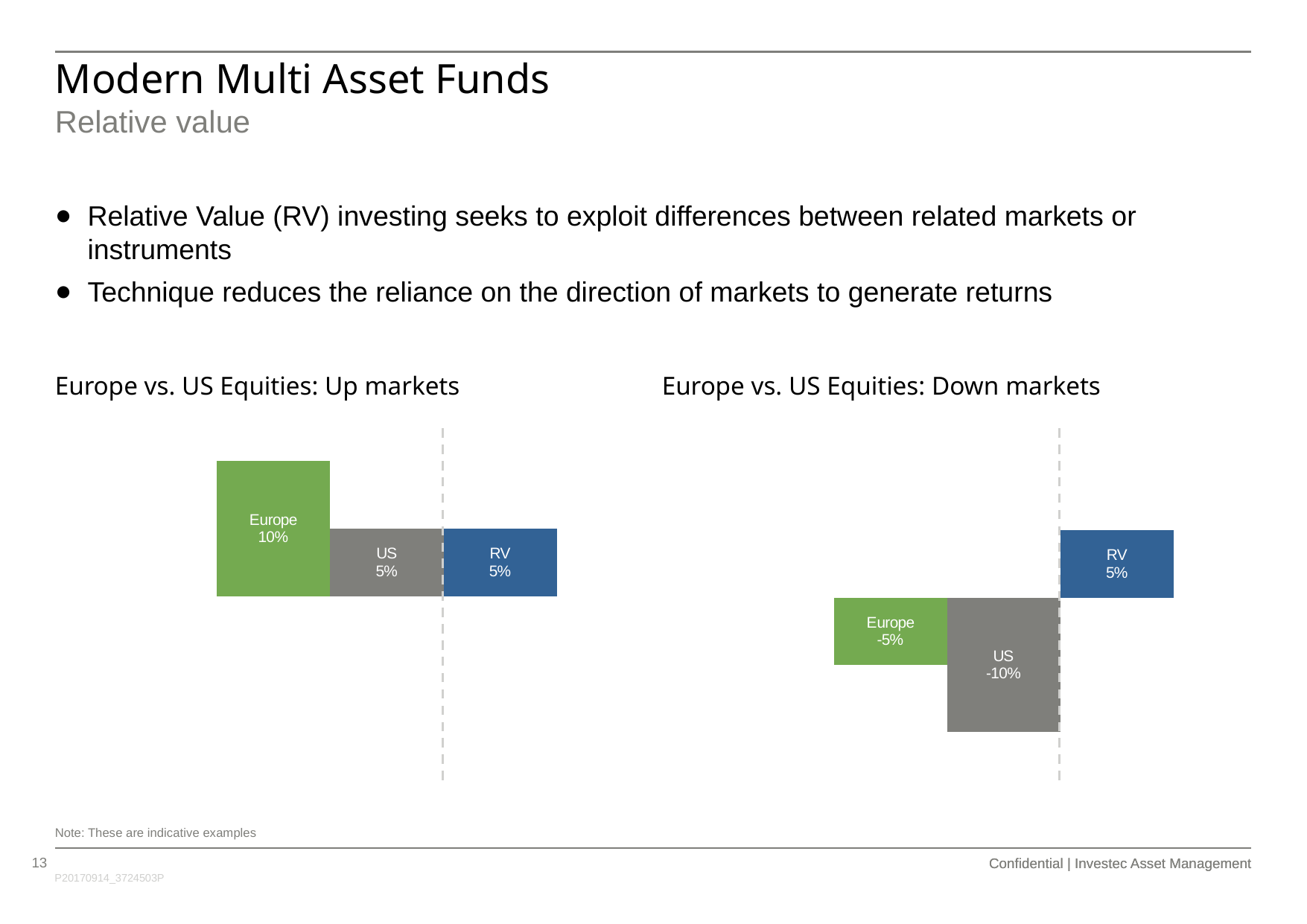
In the 'Europe vs. US Equities: Down markets' chart, which is larger, the Europe value or the US value? Europe In the 'Europe vs. US Equities: Down markets' chart, what is the value for Europe? -5% In the 'Europe vs. US Equities: Up markets' chart, what is the value for US? 5% In the 'Europe vs. US Equities: Up markets' chart, what is the RV value? 5% How many bars are shown in the 'Europe vs. US Equities: Down markets' chart? 3 In the 'Europe vs. US Equities: Up markets' chart, what is the value for Europe? 10% In the 'Europe vs. US Equities: Down markets' chart, which bar has the lowest value? US In the 'Europe vs. US Equities: Down markets' chart, what is the RV value? 5% In the 'Europe vs. US Equities: Up markets' chart, which bar is the highest? Europe In the 'Europe vs. US Equities: Down markets' chart, what is the value for US? -10% What type of chart is 'Europe vs. US Equities: Up markets'? Bar chart In the 'Europe vs. US Equities: Up markets' chart, what is the difference between the Europe and US values? 5%